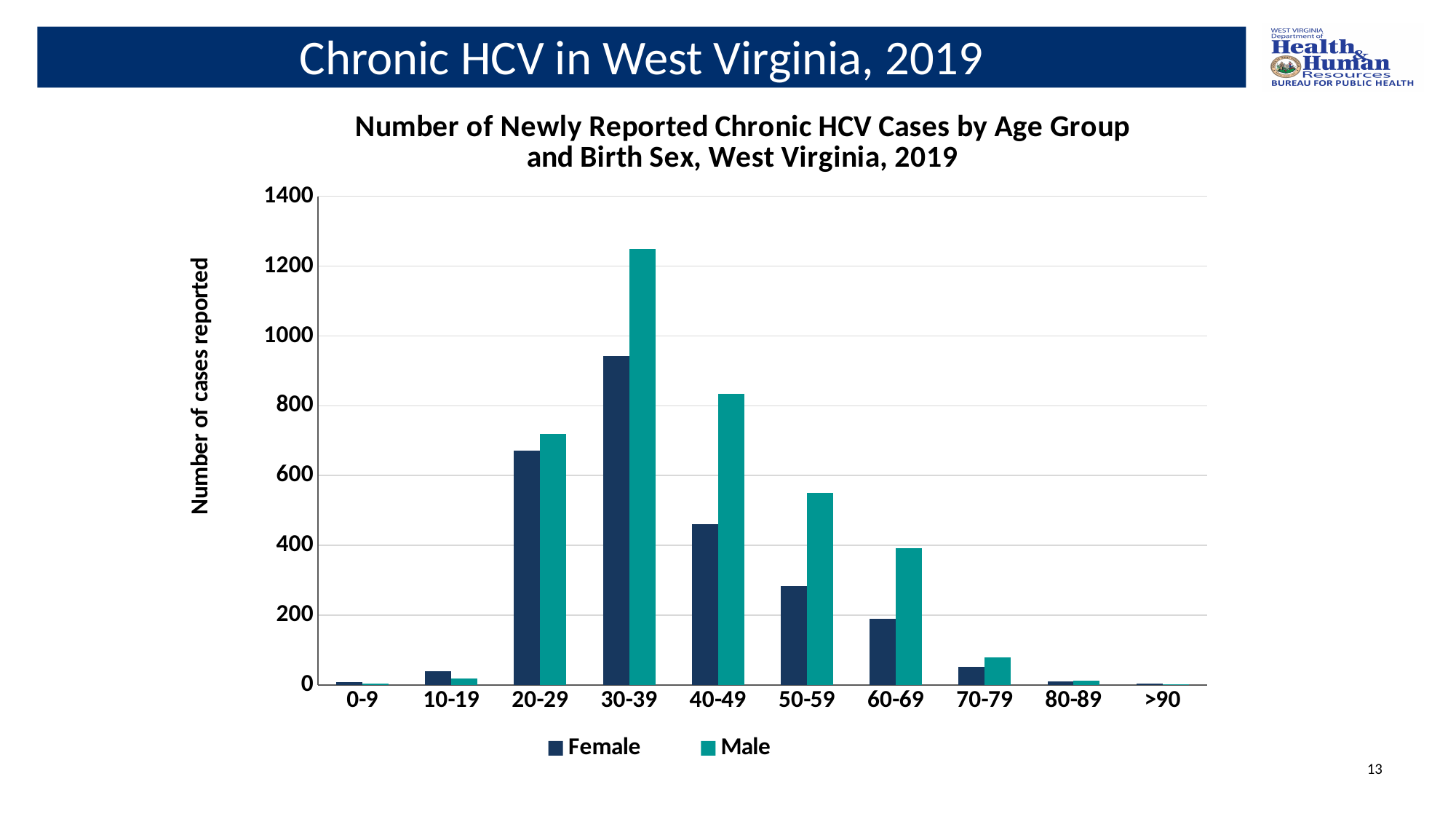
How many series does the legend list? 2 For the 60-69 age group, which is larger, the Female value or the Male value? Male What is the label of the y axis? Number of cases reported Which age group has the highest number of Male cases? 30-39 Is the Female value for the 50-59 age group greater or less than 400? less What kind of chart is shown on the slide? bar chart How many age groups are shown on the x axis? 10 Is the Male value for the 30-39 age group greater or less than 1200? greater Is the Female value for the 30-39 age group greater or less than 1000? less Which age group has the highest number of Female cases? 30-39 Which is larger, the Male value for 20-29 or the Male value for 50-59? 20-29